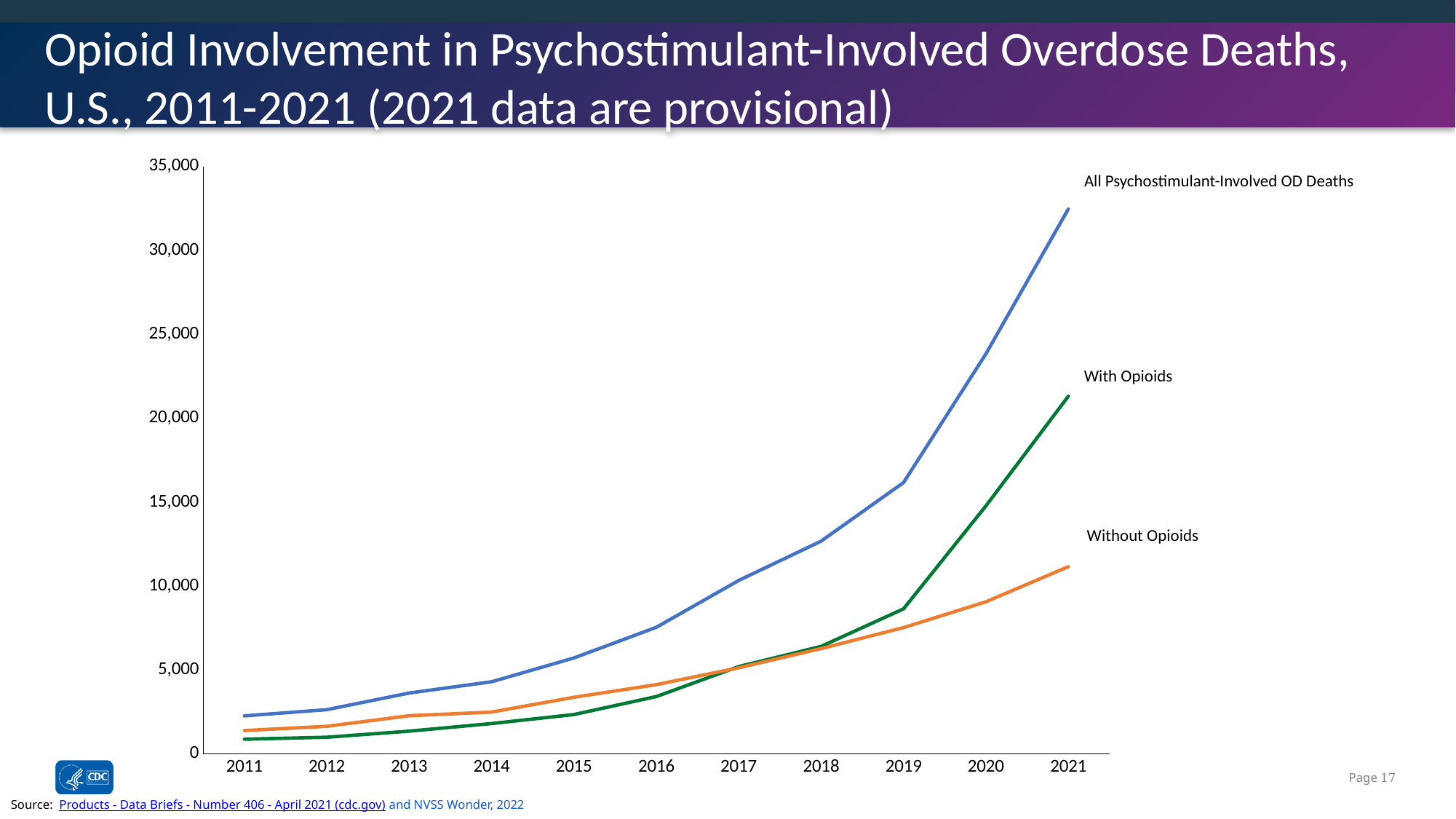
In which year is the value for With Opioids lowest? 2011 In which year is the value for All Psychostimulant-Involved OD Deaths highest? 2021 How many years are shown along the x axis? 11 Is the value for With Opioids in 2019 greater or less than 10,000? less Is the value for All Psychostimulant-Involved OD Deaths in 2021 greater or less than 30,000? greater How many series (lines) are plotted on the chart? 3 Is the value for With Opioids in 2021 greater or less than 20,000? greater Do the values for All Psychostimulant-Involved OD Deaths rise or fall from 2011 to 2021? rise In 2021, which is larger: With Opioids or Without Opioids? With Opioids In 2015, which is larger: With Opioids or Without Opioids? Without Opioids Which series is shown by the blue line? All Psychostimulant-Involved OD Deaths What kind of chart is shown on the slide? line chart